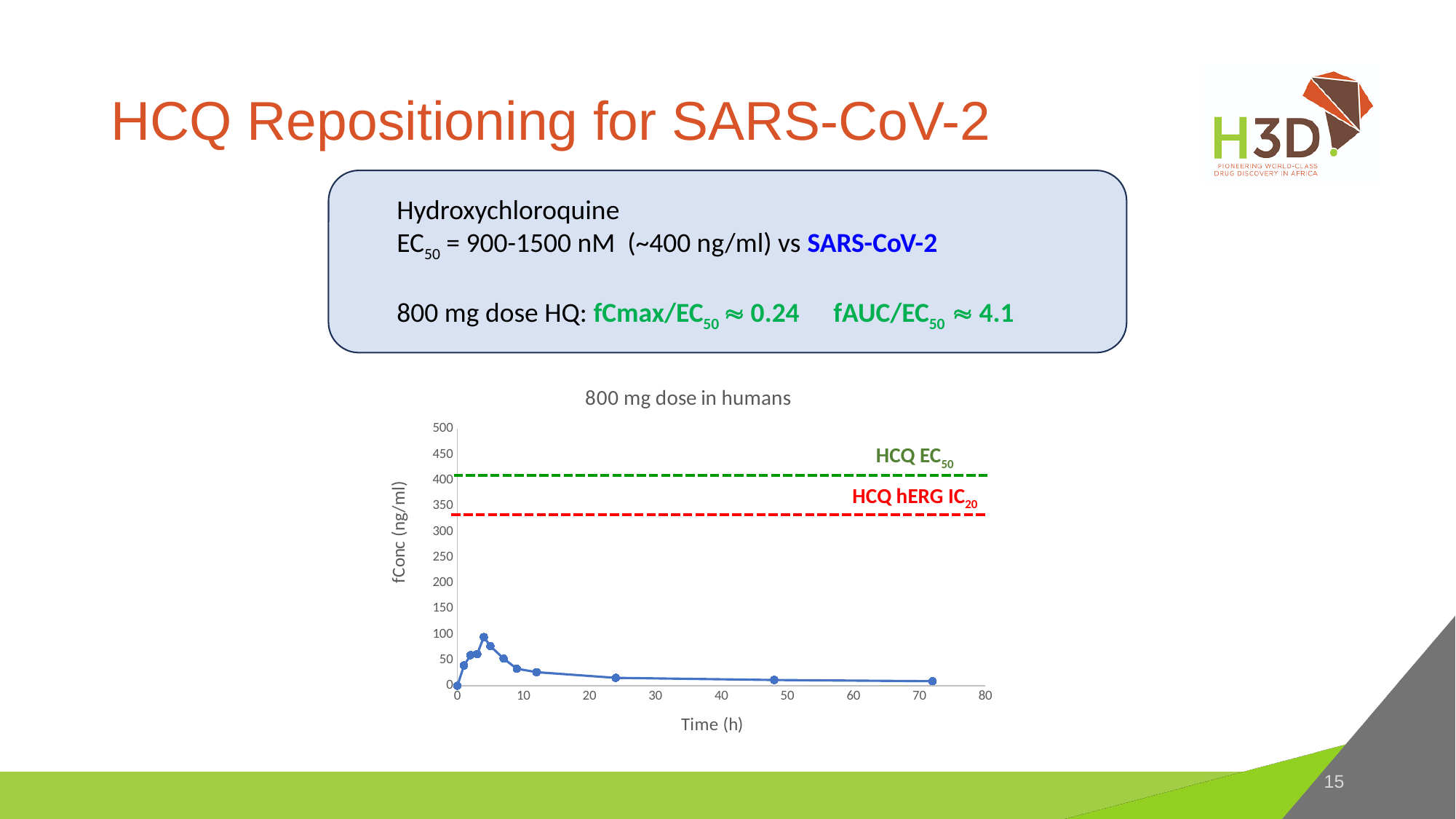
Is the peak concentration of the blue curve greater or less than the HCQ hERG IC20 line? less Which dashed reference line is higher, HCQ EC50 or HCQ hERG IC20? HCQ EC50 After the peak at around 4 h, does the concentration rise or fall as time increases? fall What is the label of the y axis of the chart? fConc (ng/ml) What is the title of the chart? 800 mg dose in humans Is the HCQ hERG IC20 dashed line greater or less than 350? less Is the HCQ EC50 dashed line greater or less than 350? greater Is the peak value of the blue concentration curve greater or less than 150? less What kind of chart is shown on the slide? line chart What is the highest tick value shown on the x axis (Time (h))? 80